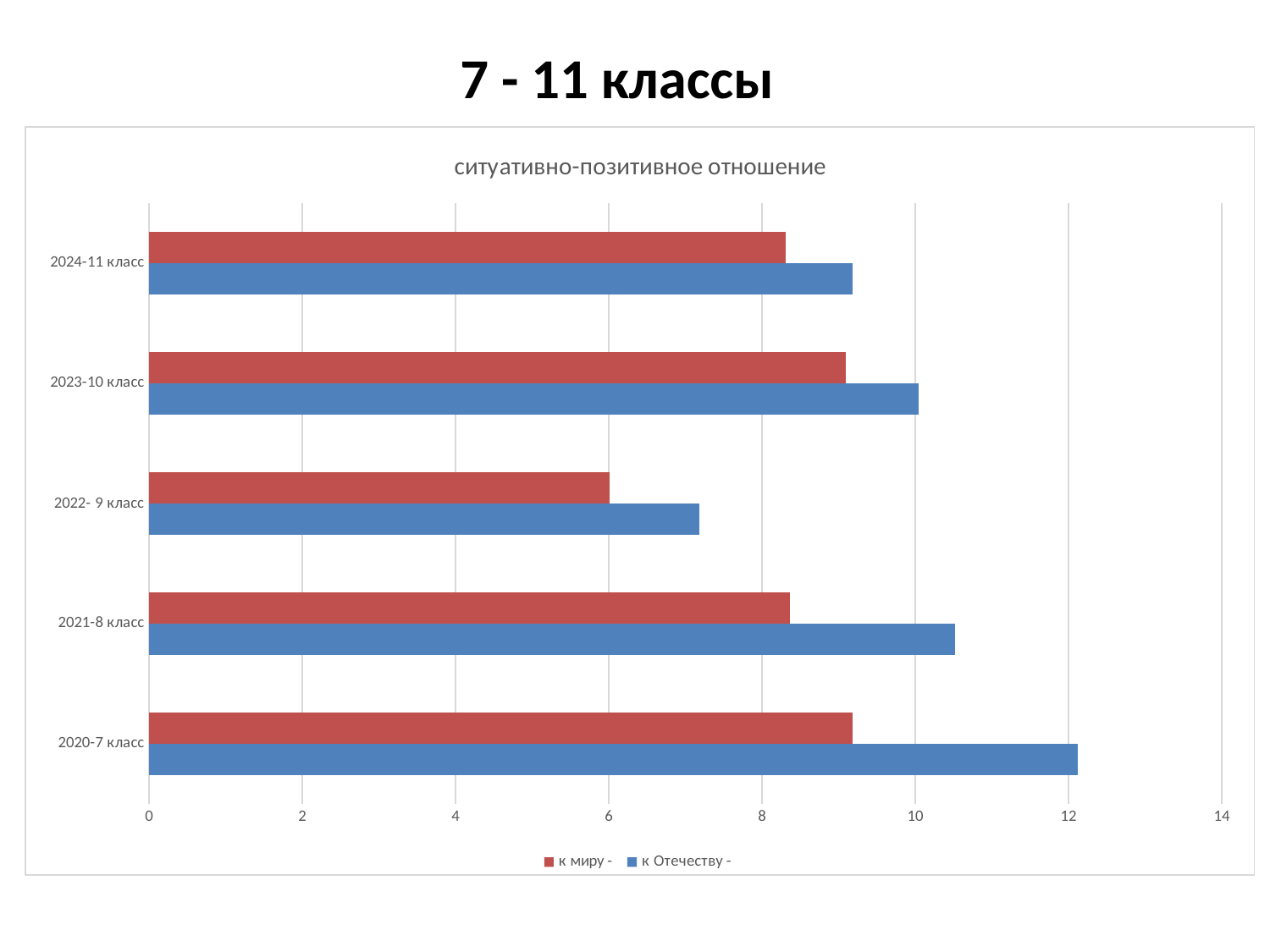
For 2020-7 класс, which series has the larger value, "к миру -" or "к Отечеству -"? к Отечеству - Which category has the lowest value for the series "к Отечеству -"? 2022- 9 класс Is the value for "к Отечеству -" in 2020-7 класс greater or less than 10? greater Is the value for "к миру -" in 2023-10 класс greater or less than 10? less Which category has the highest value for the series "к Отечеству -"? 2020-7 класс For the series "к Отечеству -", which is larger: 2021-8 класс or 2024-11 класс? 2021-8 класс What kind of chart is shown on the slide? bar chart Is the value for "к Отечеству -" in 2022- 9 класс greater or less than 8? less What is the title of the chart? ситуативно-позитивное отношение Which category has the lowest value for the series "к миру -"? 2022- 9 класс How many series does the legend list? 2 How many categories (classes) are shown on the chart? 5